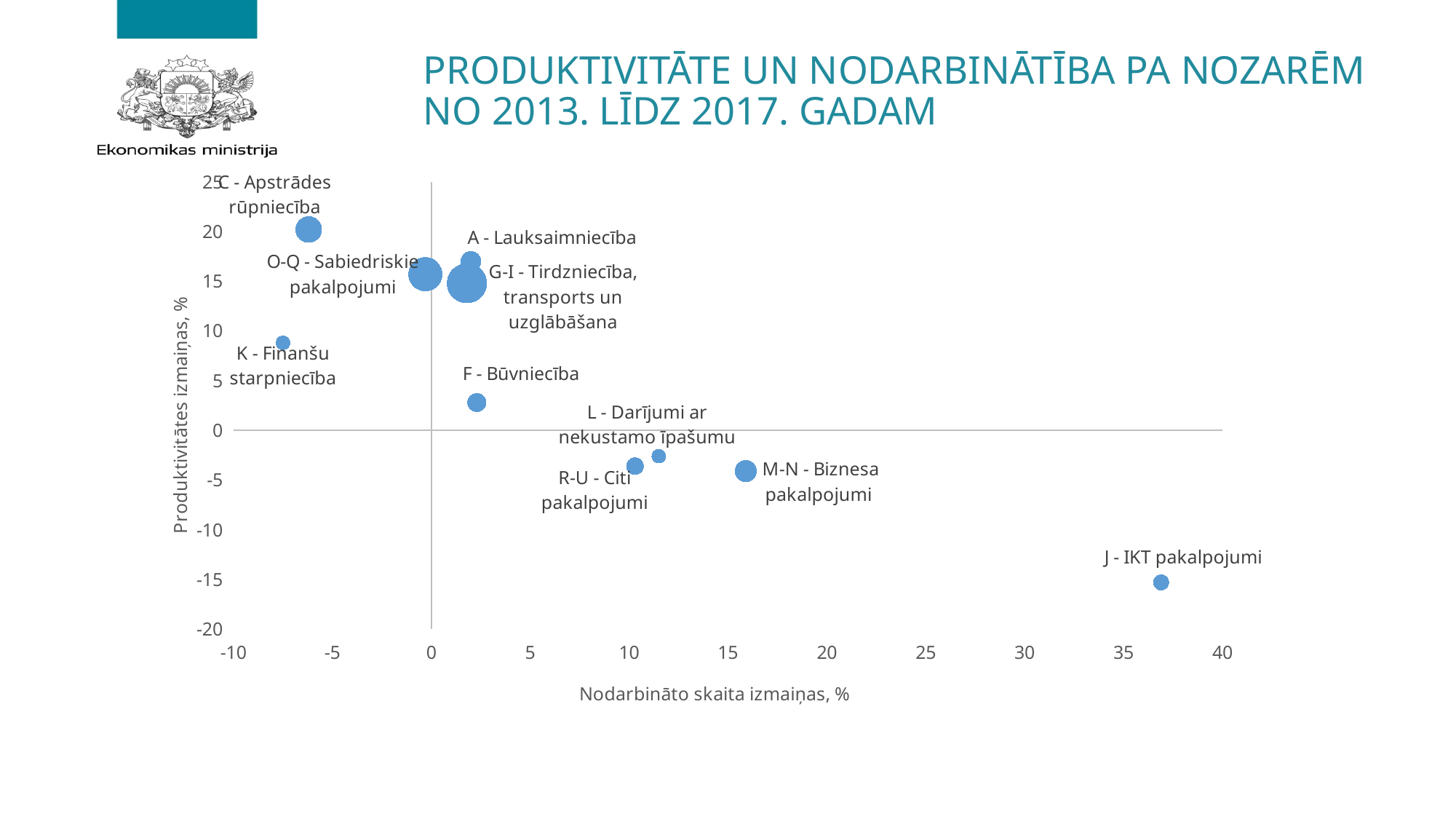
Which has the larger employment change, M-N - Biznesa pakalpojumi or R-U - Citi pakalpojumi? M-N - Biznesa pakalpojumi Is the employment change for J - IKT pakalpojumi greater or less than 35? greater Is the productivity change for F - Būvniecība greater or less than 5? less How many sectors (bubbles) are plotted on the chart? 10 What kind of chart is shown on the slide? bubble chart Which sector has the lowest productivity change (lowest on the y axis)? J - IKT pakalpojumi Is the productivity change for J - IKT pakalpojumi greater or less than -10? less What is the title of the x axis? Nodarbināto skaita izmaiņas, % Which sector has the highest productivity change (highest on the y axis)? C - Apstrādes rūpniecība Which sector has the largest change in number of employed (furthest right on the x axis)? J - IKT pakalpojumi